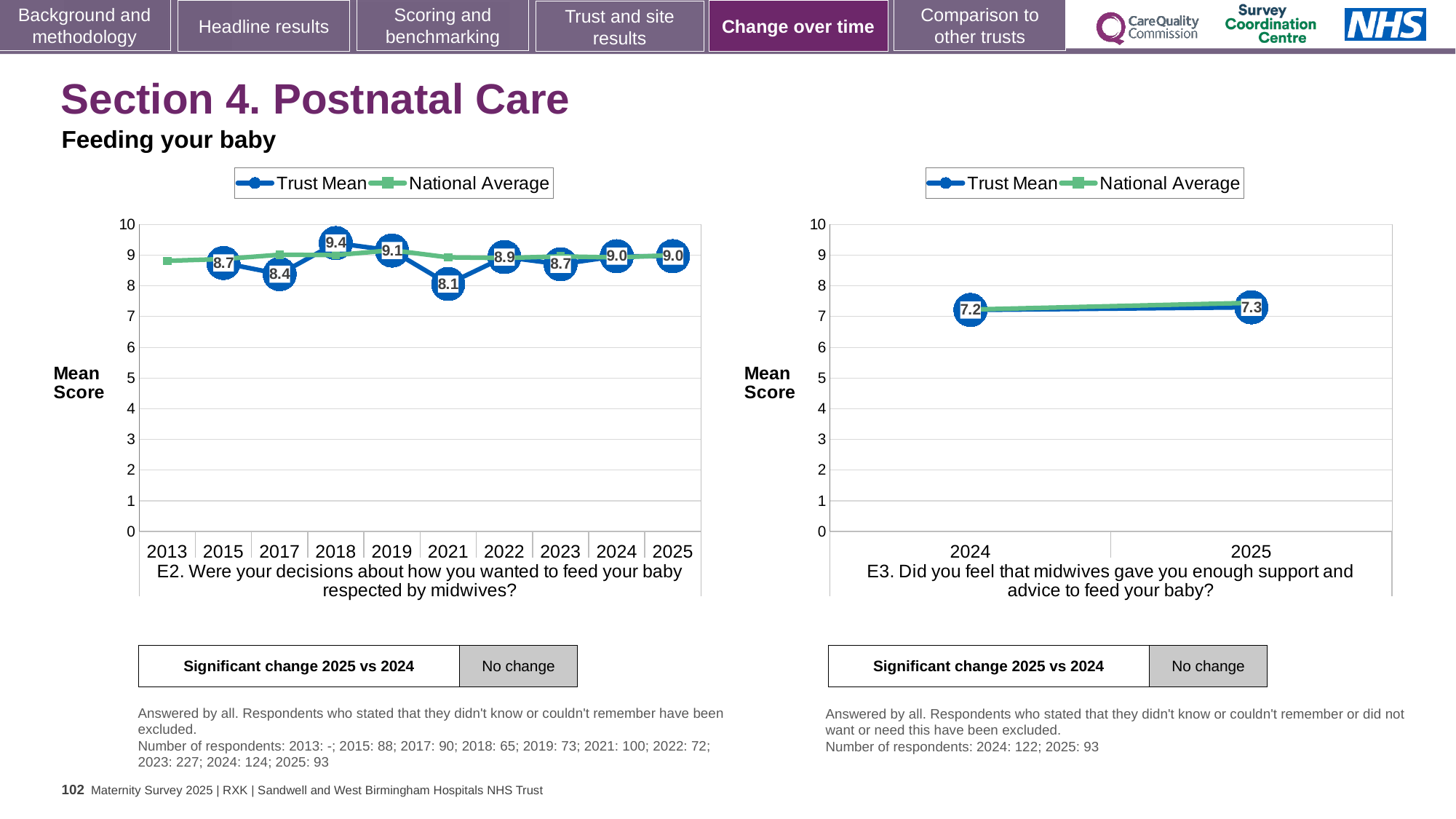
In the E2 chart on the left, which year has the lowest Trust Mean? 2021 How many years are shown on the x axis of the E2 chart on the left? 10 In the E2 chart on the left, what is the Trust Mean for 2021? 8.1 In the E3 chart on the right, what is the Trust Mean for 2025? 7.3 In the E2 chart on the left, which is larger: the Trust Mean for 2017 or the Trust Mean for 2022? 2022 What kind of chart is the E3 chart on the right? Line chart In the E3 chart on the right, is the Trust Mean for 2024 greater or less than 8? less How many series does the legend of the E3 chart on the right list? 2 In the E2 chart on the left, what is the difference between the Trust Mean for 2018 and the Trust Mean for 2021? 1.3 In the E3 chart on the right, what is the difference between the Trust Mean for 2025 and the Trust Mean for 2024? 0.1 In the E2 chart on the left, what is the Trust Mean for 2018? 9.4 In the E2 chart on the left, which year has the highest Trust Mean? 2018